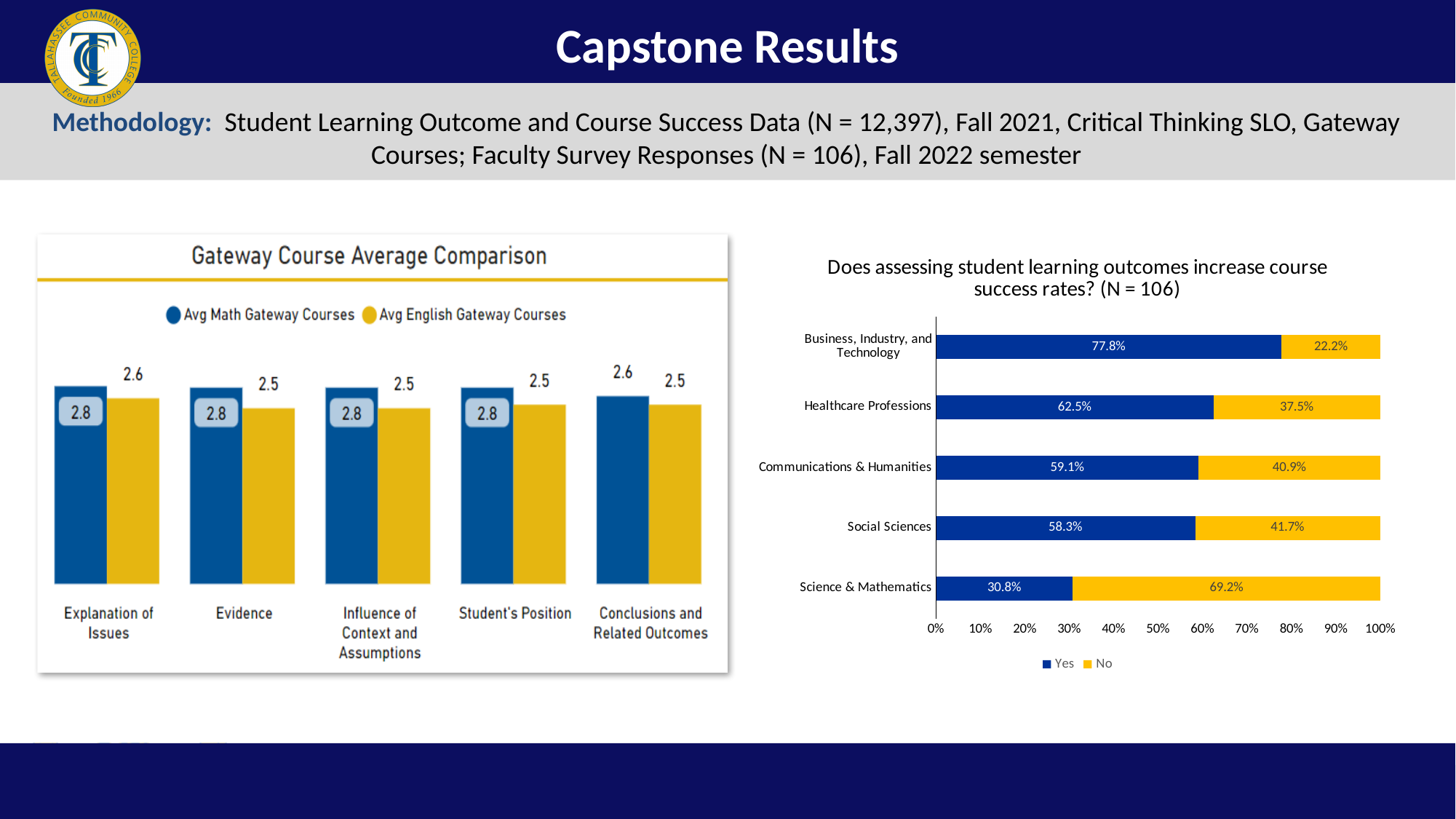
In the 'Gateway Course Average Comparison' chart, how many series does the legend list? 2 In the 'Gateway Course Average Comparison' chart, how many categories are shown on the x axis? 5 In the chart titled 'Does assessing student learning outcomes increase course success rates? (N = 106)', what is the difference between the Yes percentages for Business, Industry, and Technology and Social Sciences? 19.5% In the chart titled 'Does assessing student learning outcomes increase course success rates? (N = 106)', what percentage of Science & Mathematics respondents answered No? 69.2% In the 'Gateway Course Average Comparison' chart, what is the difference between the Avg Math and Avg English values for Evidence? 0.3 In the 'Gateway Course Average Comparison' chart, what is the value for Avg Math Gateway Courses for Conclusions and Related Outcomes? 2.6 In the 'Gateway Course Average Comparison' chart, which series is larger for Student's Position, Avg Math Gateway Courses or Avg English Gateway Courses? Avg Math Gateway Courses In the chart titled 'Does assessing student learning outcomes increase course success rates? (N = 106)', which category has the lowest Yes percentage? Science & Mathematics In the chart titled 'Does assessing student learning outcomes increase course success rates? (N = 106)', which category has the highest Yes percentage? Business, Industry, and Technology In the 'Gateway Course Average Comparison' chart, what is the value for Avg English Gateway Courses for Explanation of Issues? 2.6 What kind of chart is the one titled 'Does assessing student learning outcomes increase course success rates? (N = 106)'? Stacked bar chart In the chart titled 'Does assessing student learning outcomes increase course success rates? (N = 106)', what percentage of Healthcare Professions respondents answered Yes? 62.5%